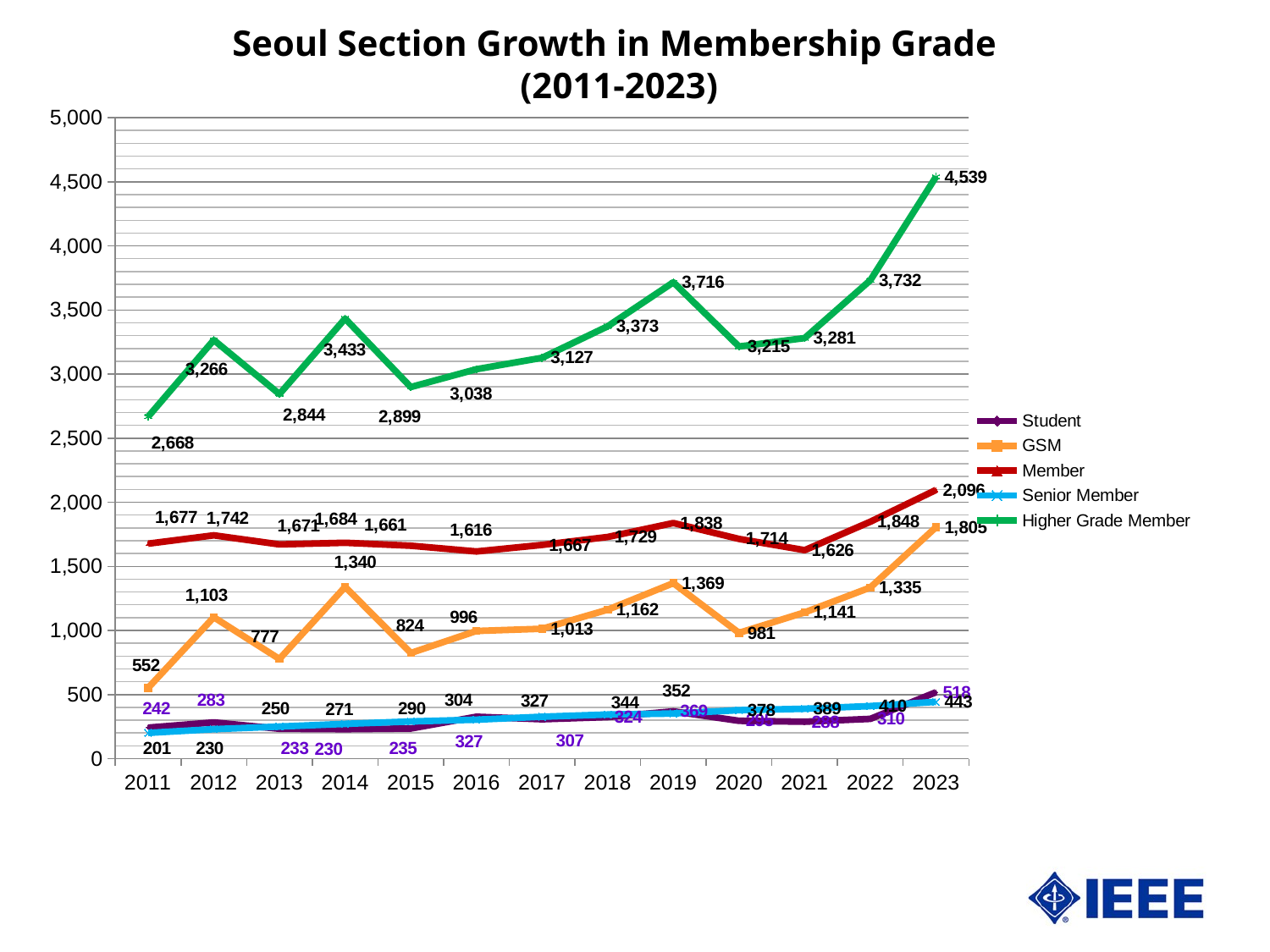
What is the title of the chart? Seoul Section Growth in Membership Grade (2011-2023) What is the Member value in 2019? 1,838 In which year is the GSM value highest? 2023 What type of chart is shown on the slide? line chart How many years are plotted along the x axis? 13 What is the Higher Grade Member value in 2023? 4,539 Which is larger, the GSM value in 2014 or the GSM value in 2019? 2019 What is the GSM value in 2011? 552 How many series does the legend list? 5 What is the difference between the Higher Grade Member values in 2023 and 2022? 807 In which year is the Higher Grade Member value lowest? 2011 Is the Member value in 2023 greater or less than 2,000? greater